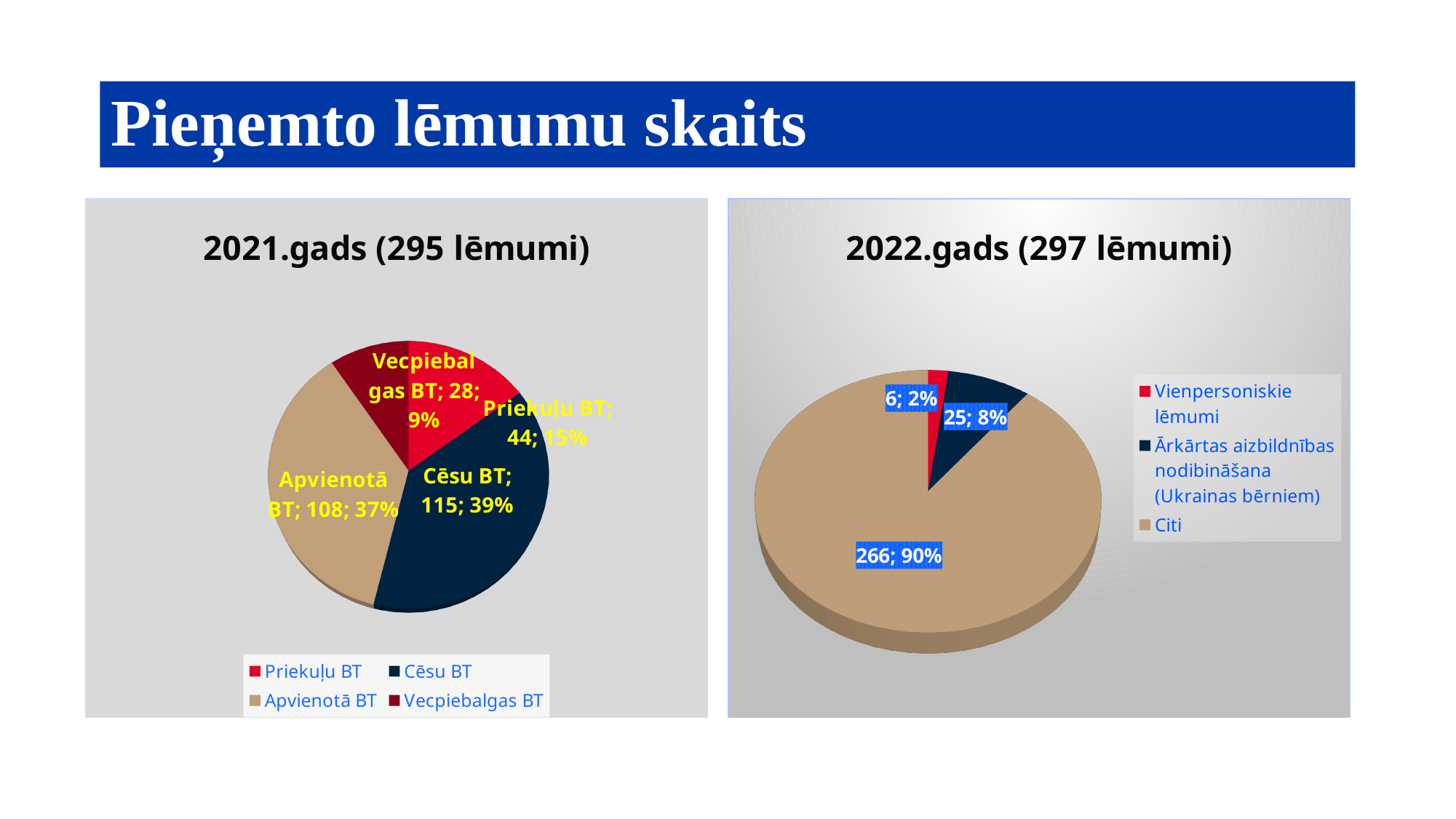
What is the title of the slide? Pieņemto lēmumu skaits In the 2021.gads (295 lēmumi) chart, what is the difference between the values for Priekuļu BT and Vecpiebalgas BT? 16 In the 2022.gads (297 lēmumi) chart, which category has the smallest slice? Vienpersoniskie lēmumi In the 2022.gads (297 lēmumi) chart, what is the value for Citi? 266 In the 2021.gads (295 lēmumi) chart, which category has the largest slice? Cēsu BT What kind of chart is the 2022.gads (297 lēmumi) chart? Pie chart In the 2022.gads (297 lēmumi) chart, how many entries does the legend list? 3 In the 2021.gads (295 lēmumi) chart, which category has the smallest slice? Vecpiebalgas BT In the 2021.gads (295 lēmumi) chart, what is the value for Cēsu BT? 115 In the 2021.gads (295 lēmumi) chart, how many categories are shown? 4 In the 2021.gads (295 lēmumi) chart, what share of the pie does Apvienotā BT have? 37% In the 2022.gads (297 lēmumi) chart, what share of the pie does Ārkārtas aizbildnības nodibināšana (Ukrainas bērniem) have? 8%